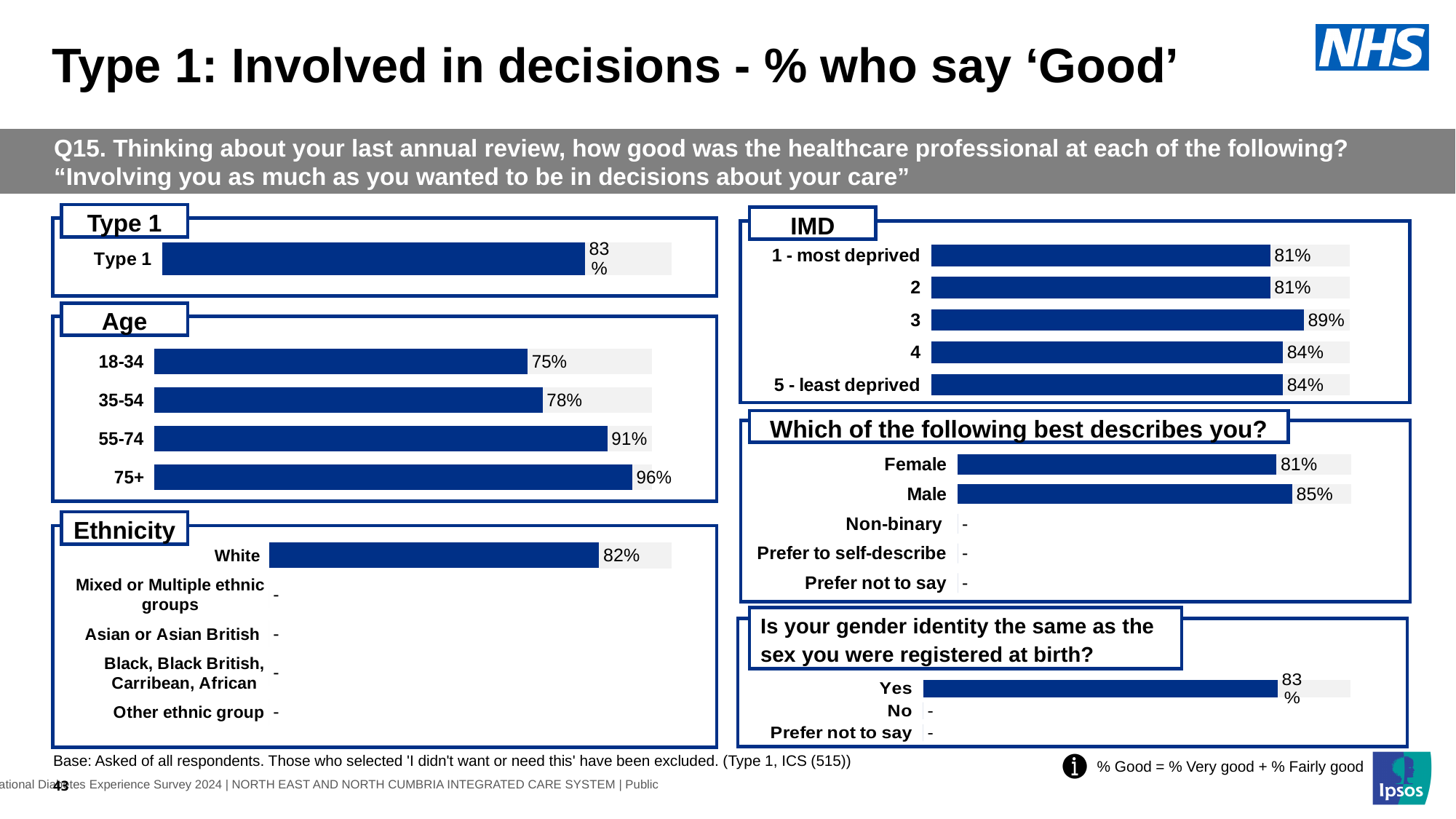
In the 'Is your gender identity the same as the sex you were registered at birth?' chart, what is the value for Yes? 83% In the IMD chart, which category has the highest value? 3 What kind of chart is the Age chart? bar chart In the 'Which of the following best describes you?' chart, what is the difference between the Male and Female values? 4 percentage points In the Age chart, which age group has the lowest value? 18-34 In the Ethnicity chart, what is the value for White? 82% In the IMD chart, how many categories are shown? 5 In the IMD chart, what is the value for 1 - most deprived? 81% In the Age chart, what is the difference between the 55-74 and 35-54 values? 13 percentage points In the 'Which of the following best describes you?' chart, which is larger, Female or Male? Male In the Age chart, what is the value for the 75+ group? 96% In the Age chart, do the values rise or fall as age increases from 18-34 to 75+? rise